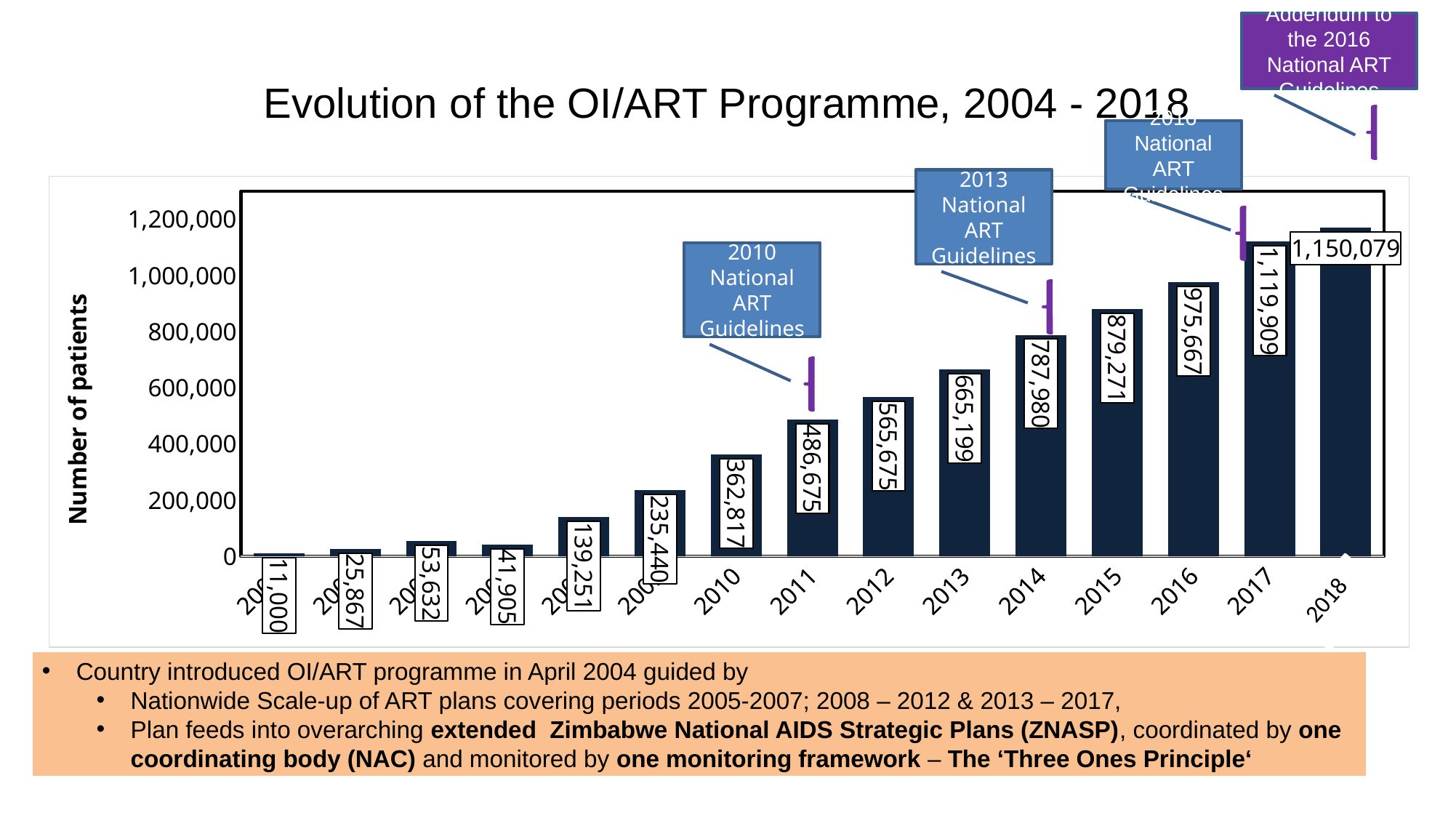
How many years (bars) are shown in the chart? 15 What kind of chart is shown on the slide? bar chart What is the number of patients in 2018? 1,150,079 What is the number of patients in 2017? 1,119,909 Which year has the highest number of patients? 2018 What is the number of patients in 2010? 362,817 What is the number of patients in 2014? 787,980 What is the difference in the number of patients between 2018 and 2017? 30,170 Is the value for 2011 greater or less than 400,000? greater What is the label of the vertical axis? Number of patients Which year has more patients, 2012 or 2013? 2013 What is the difference in the number of patients between 2016 and 2015? 96,396